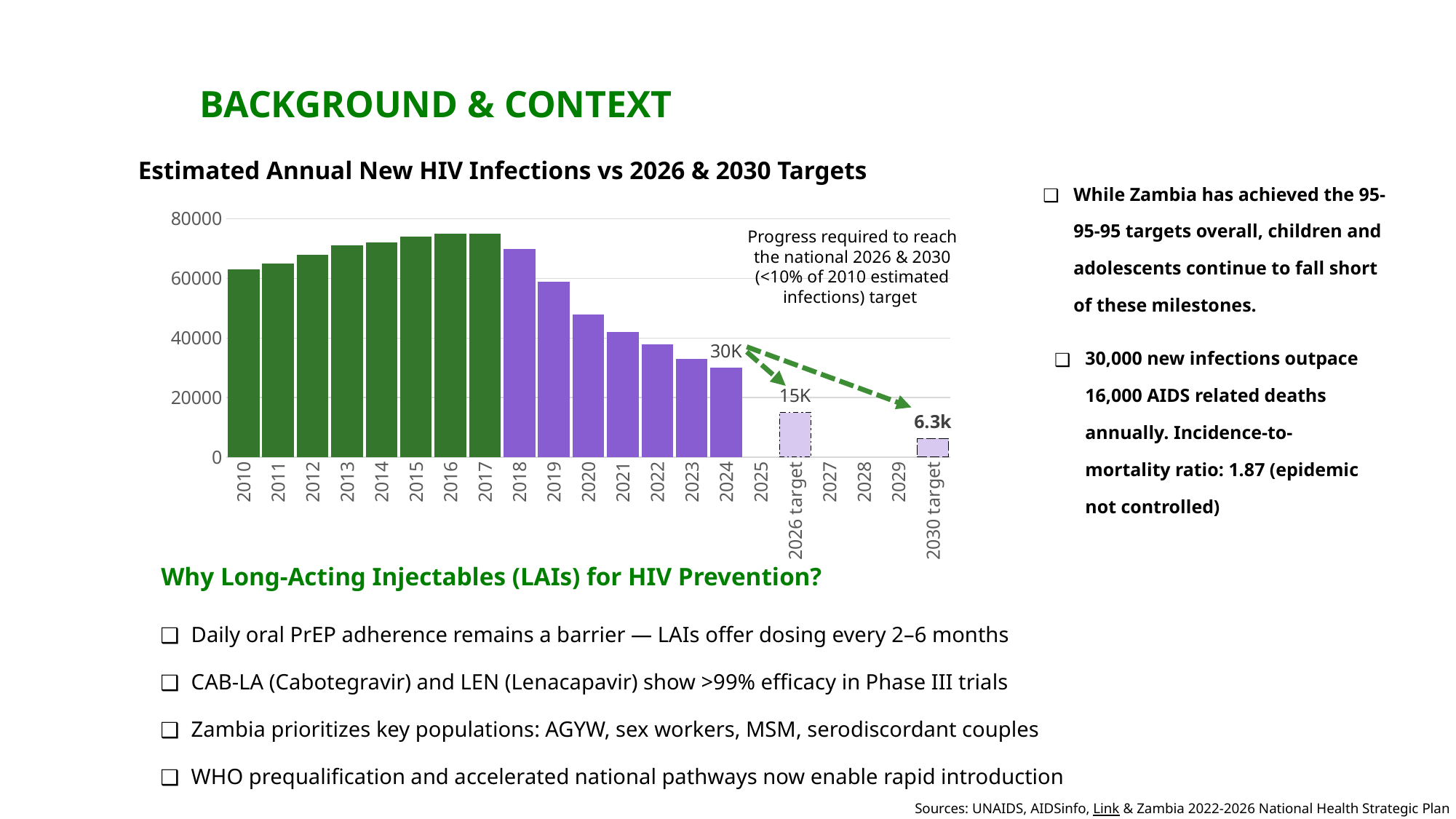
Which is larger, the value for 2018 or the value for 2024? 2018 What value is labelled on the bar for 2024? 30K What kind of chart is shown on the slide? bar chart What value is labelled on the 2030 target bar? 6.3k What value is labelled on the 2026 target bar? 15K Among the years 2010 to 2024, which year has the lowest bar? 2024 Is the value for 2010 greater or less than 60000? greater Do the values rise or fall from 2018 to 2024? fall Is the value for 2020 greater or less than 60000? less What is the title of the chart? Estimated Annual New HIV Infections vs 2026 & 2030 Targets Which bar is the lowest on the chart? 2030 target What is the difference between the 2024 value and the 2026 target? 15K